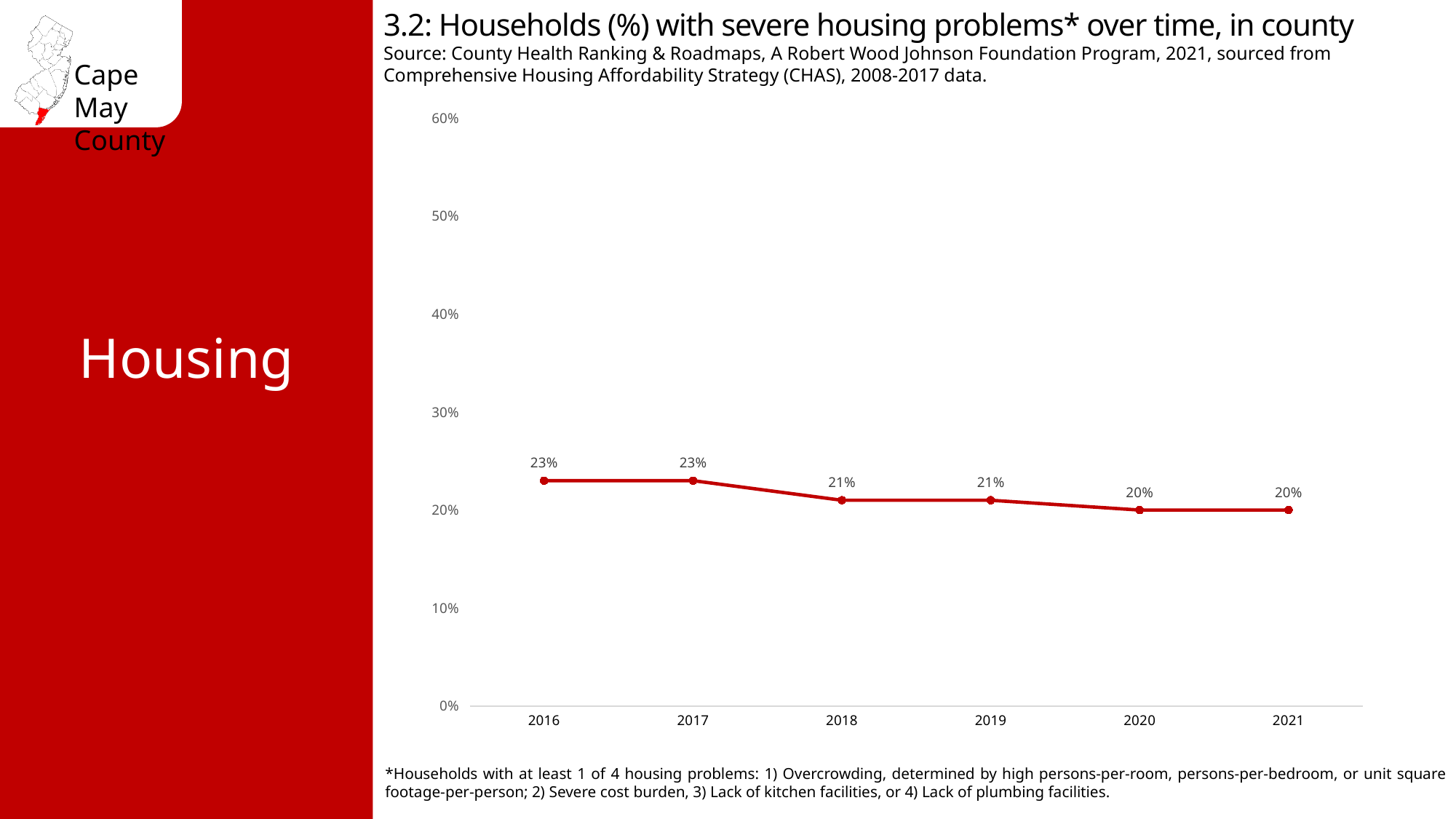
Do the values rise or fall from 2016 to 2021? fall Which is larger, the value for 2017 or the value for 2020? 2017 What percentage of households had severe housing problems in 2021? 20% Is the value for 2018 greater or less than 30%? less What is the highest value shown on the vertical axis? 60% What is the difference between the 2016 value and the 2021 value? 3% Which year has the lowest value on the chart (earliest if tied)? 2020 What is the value shown for 2018? 21% What is the value shown for 2019? 21% What kind of chart is shown on the slide? line chart How many years are plotted on the chart? 6 What percentage of households had severe housing problems in 2016? 23%